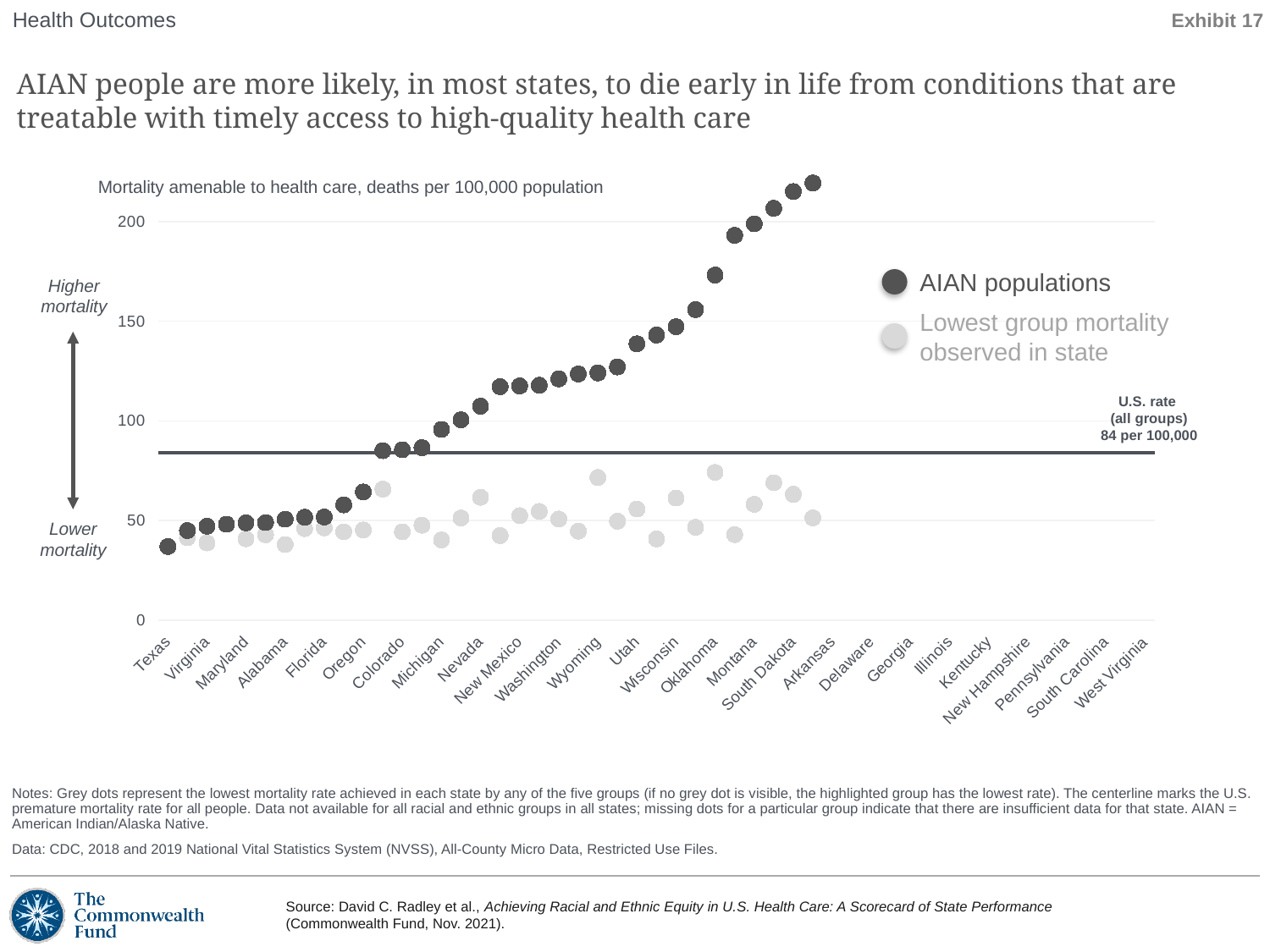
What does the chart's subtitle say is being measured? Mortality amenable to health care, deaths per 100,000 population How many series does the legend list? 2 Is the AIAN mortality value for Utah greater or less than 100? greater Which state has the lowest AIAN mortality value on the chart? Texas Is the AIAN mortality value for Texas greater or less than 50? less What kind of chart is shown on the slide? Dot (scatter) chart Do the AIAN population values rise or fall moving from left to right along the x axis? Rise Which state has the larger AIAN mortality value, Virginia or Montana? Montana What U.S. rate (all groups) does the horizontal centerline mark? 84 per 100,000 Is the AIAN mortality value for Oklahoma greater or less than 150? greater